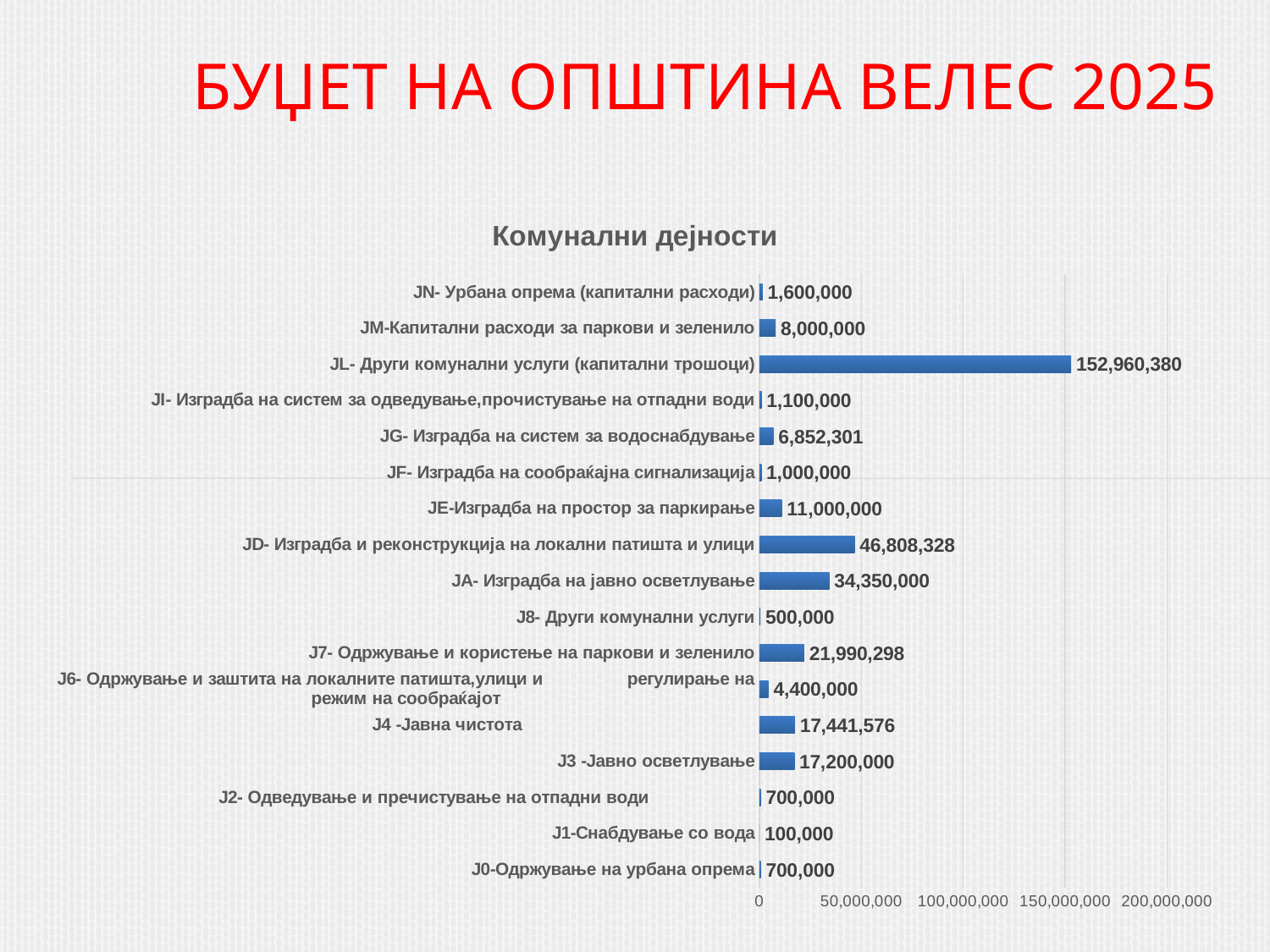
What is the difference between the values for J4 -Јавна чистота and J3 -Јавно осветлување? 241,576 How many categories are shown in the chart? 17 What is the value for JG- Изградба на систем за водоснабдување? 6,852,301 What is the value for J7- Одржување и користење на паркови и зеленило? 21,990,298 Which is larger, the value for JE-Изградба на простор за паркирање or JM-Капитални расходи за паркови и зеленило? JE-Изградба на простор за паркирање What is the difference between the values for JD- Изградба и реконструкција на локални патишта и улици and JA- Изградба на јавно осветлување? 12,458,328 Which category has the lowest value? J1-Снабдување со вода What kind of chart is shown on the slide? bar chart Which category has the highest value? JL- Други комунални услуги (капитални трошоци) What is the value for JL- Други комунални услуги (капитални трошоци)? 152,960,380 What is the value for JD- Изградба и реконструкција на локални патишта и улици? 46,808,328 Is the value for JL- Други комунални услуги (капитални трошоци) greater or less than 150,000,000? greater